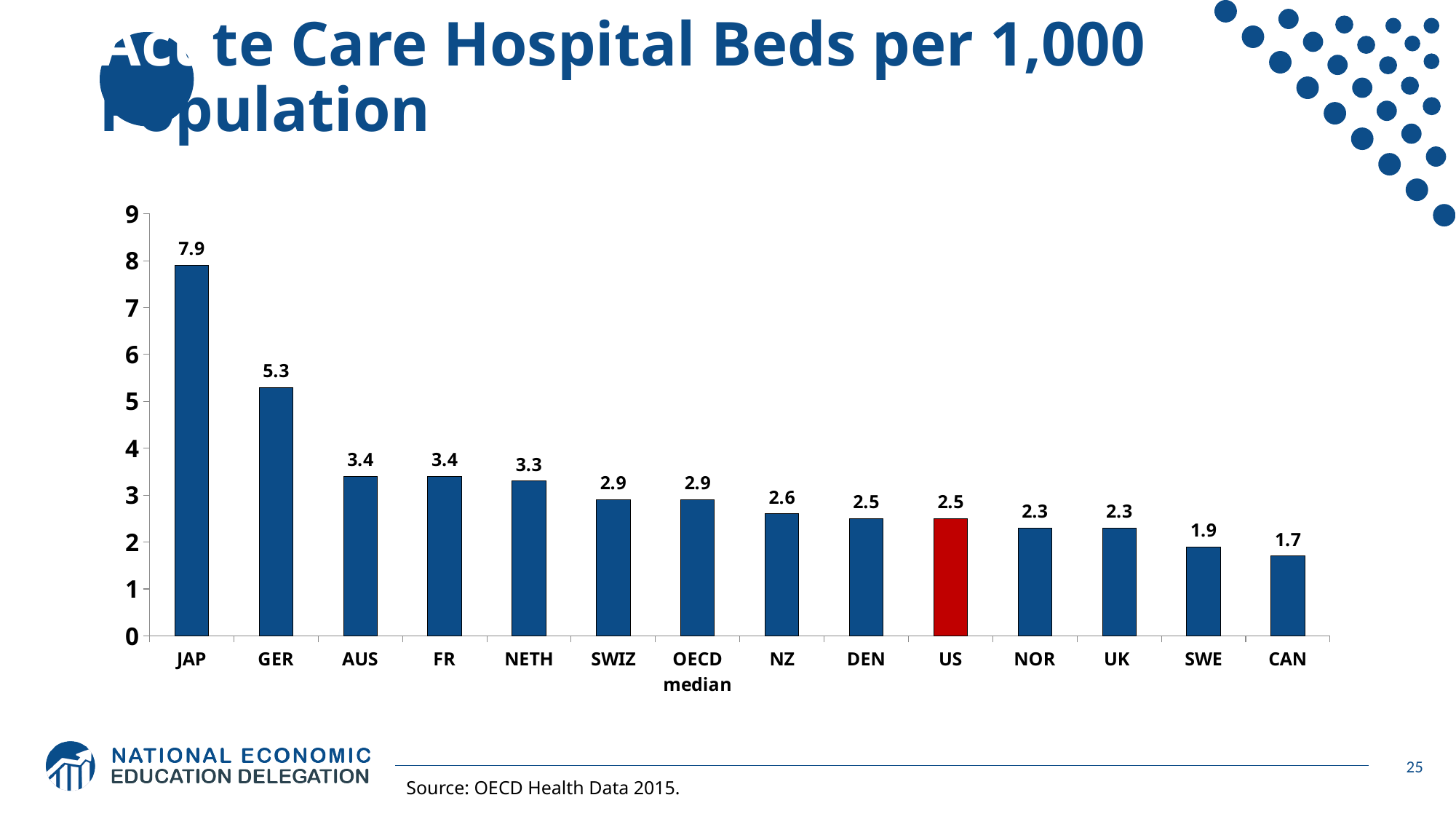
What is the difference between the values for JAP and GER? 2.6 Is the value for GER greater or less than 5? greater What kind of chart is shown on the slide? bar chart Which is larger, the value for NETH or the value for SWIZ? NETH Which category has the highest value? JAP What is the difference between the OECD median and the US value? 0.4 What is the value for the US? 2.5 Which bar is coloured red rather than blue? US What is the value for the OECD median? 2.9 What is the value for JAP? 7.9 Which category has the lowest value? CAN How many categories are shown on the x axis? 14